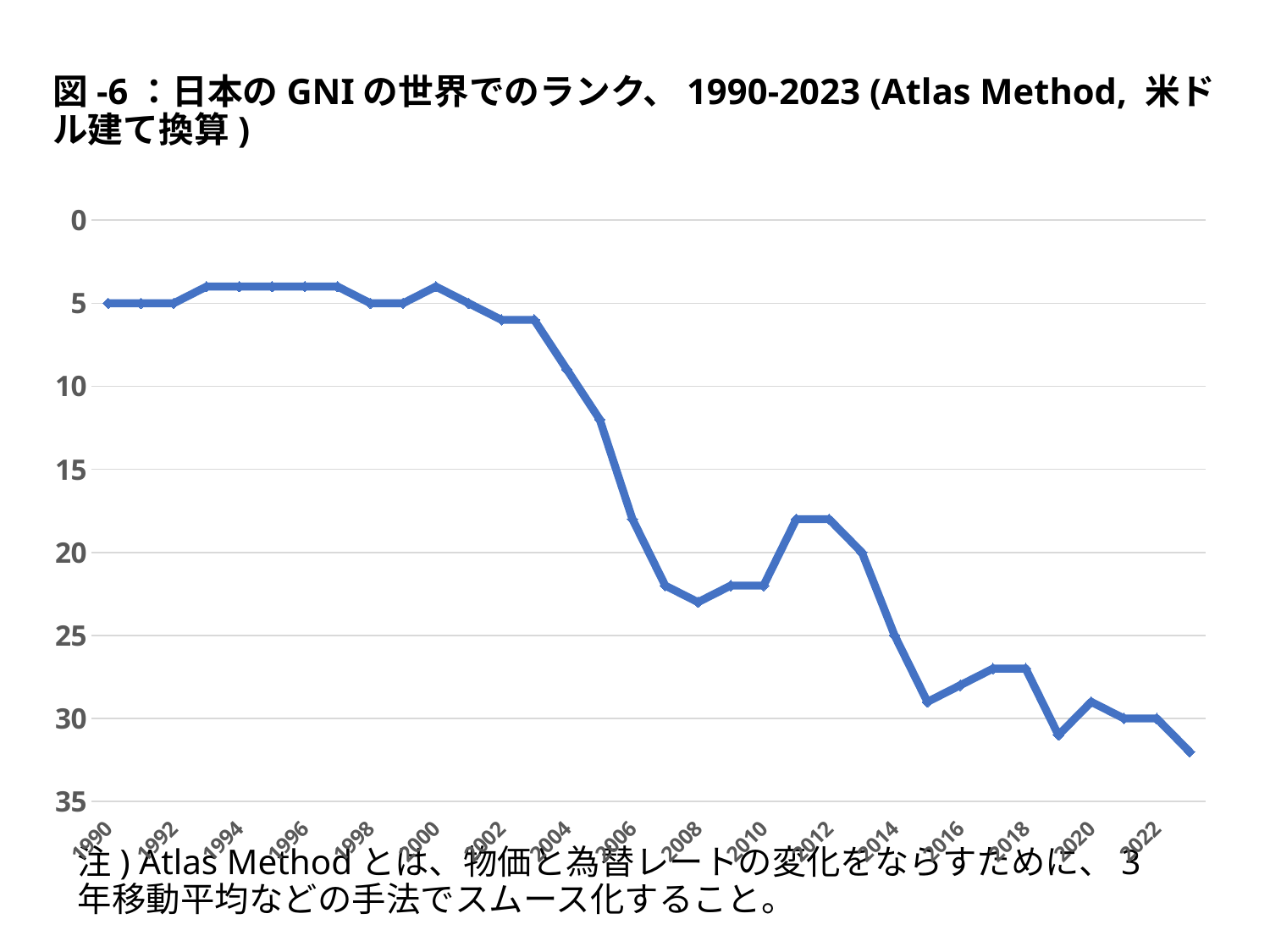
What is the value for 1998? 5 Is the value for 2012 greater or less than 20? less Is the value for 2006 greater or less than 15? greater What is the value for 2014? 25 What kind of chart is shown on the slide? line chart Is the value for 2016 greater or less than 25? greater Do the values generally rise or fall from 1990 to 2023? rise What is the value for 2022? 30 What is the first year shown on the x axis? 1990 What is the value for 1990? 5 Which year has the highest value on the chart? 2023